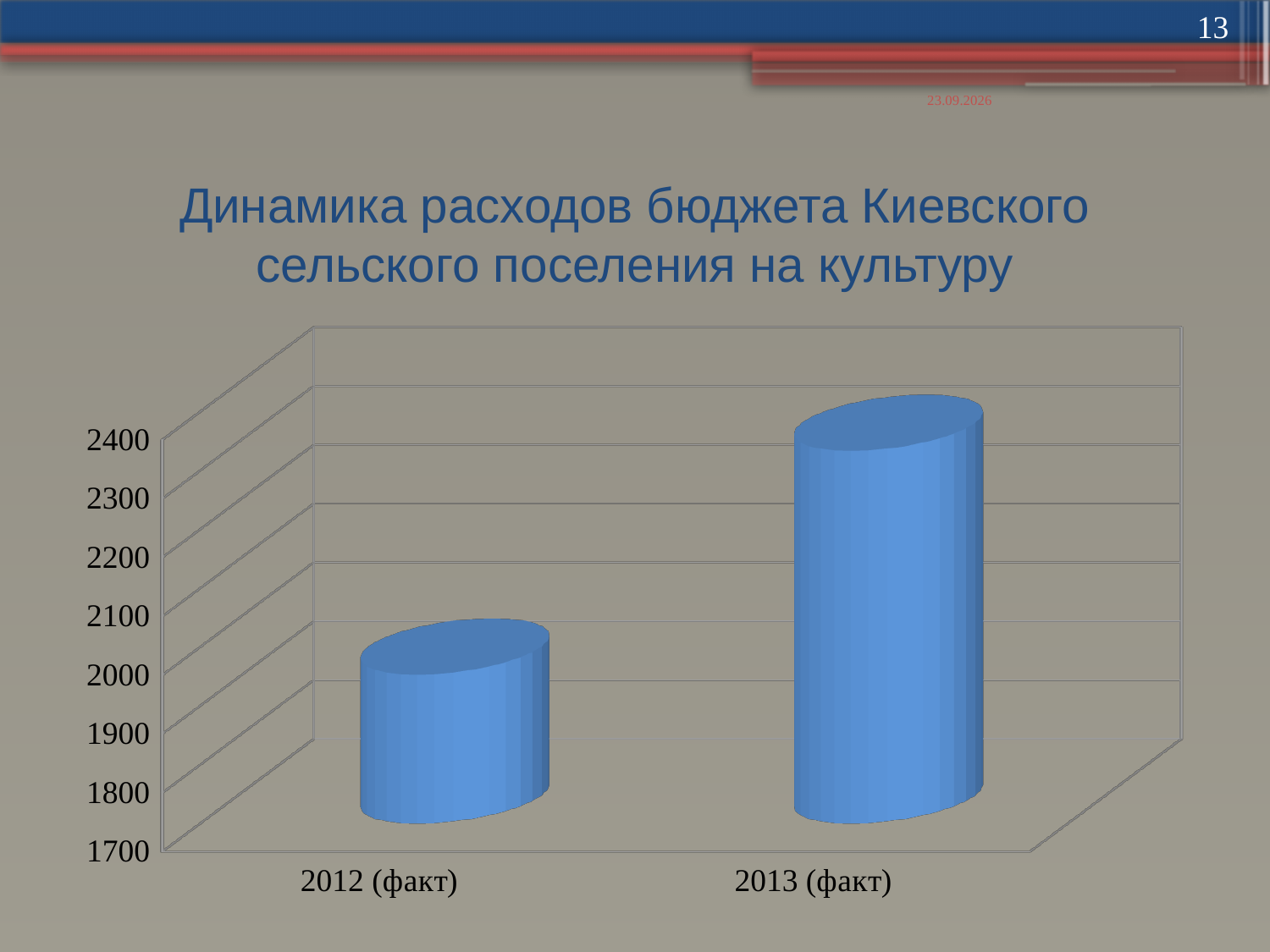
What is the lowest value shown on the vertical axis? 1700 Is the value for 2012 (факт) greater or less than 1800? greater Is the value for 2013 (факт) greater or less than 2100? greater What kind of chart is shown on the slide? bar chart Do the values rise or fall from 2012 (факт) to 2013 (факт)? rise Which category has the highest value? 2013 (факт) Is the value for 2012 (факт) greater or less than 2200? less How many categories are plotted on the x axis? 2 What is the title of the chart? Динамика расходов бюджета Киевского сельского поселения на культуру Which category has the lowest value? 2012 (факт) Which is larger, the value for 2012 (факт) or the value for 2013 (факт)? 2013 (факт)